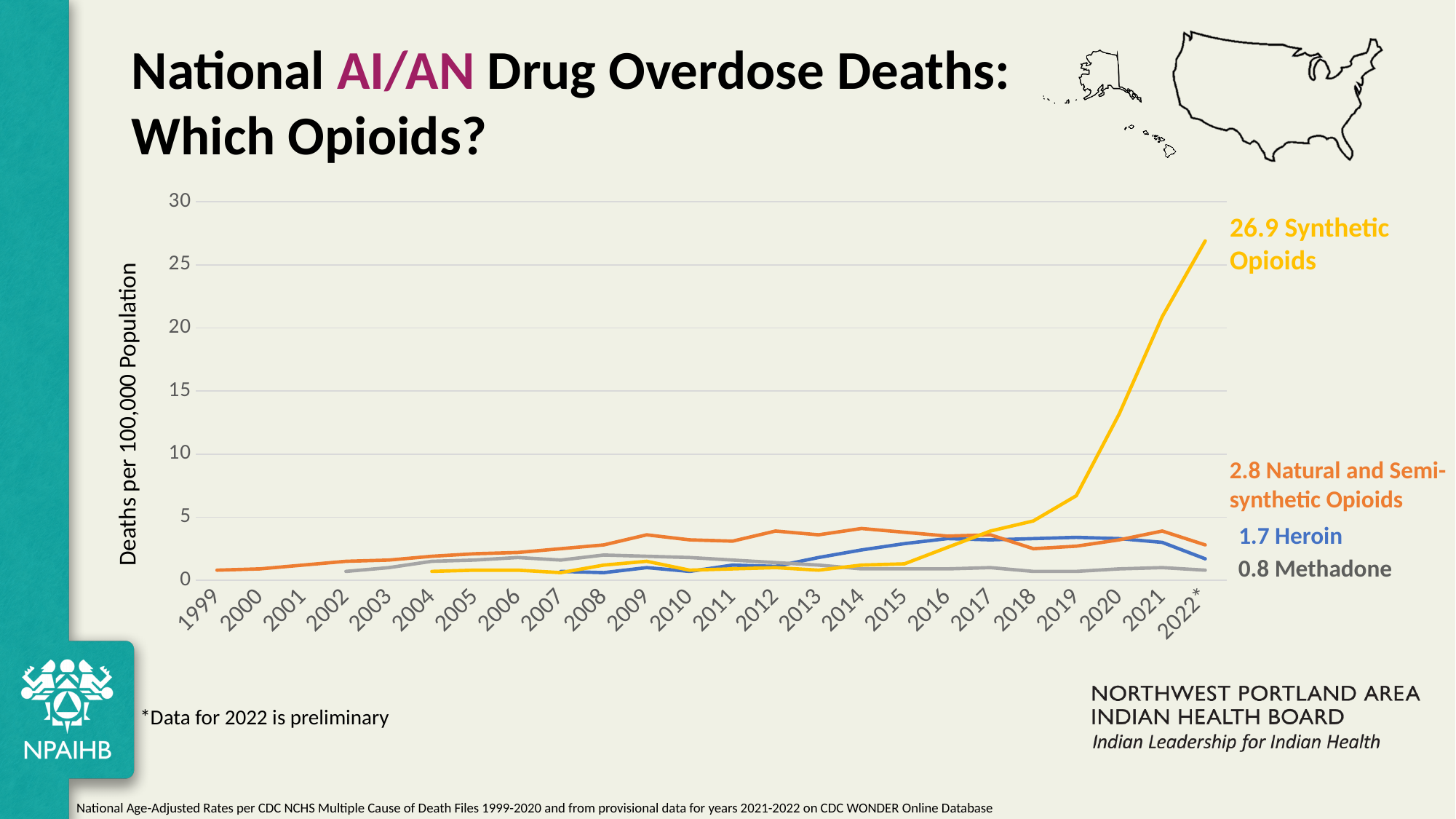
How many opioid categories (lines) are plotted on the chart? 4 What is the 2022* death rate for Heroin? 1.7 What is the 2022* death rate for Natural and Semi-synthetic Opioids? 2.8 What is the 2022* death rate for Synthetic Opioids? 26.9 What kind of chart is shown on the slide? line chart Which opioid category has the lowest death rate in 2022*? Methadone What is the difference between the 2022* rates for Synthetic Opioids and Natural and Semi-synthetic Opioids? 24.1 Which opioid category has the highest death rate in 2022*? Synthetic Opioids In 2022*, which has the larger death rate, Heroin or Methadone? Heroin Is the Synthetic Opioids death rate in 2019 greater or less than 10? less What is the 2022* death rate for Methadone? 0.8 Does the Synthetic Opioids line rise or fall between 2016 and 2022*? rise